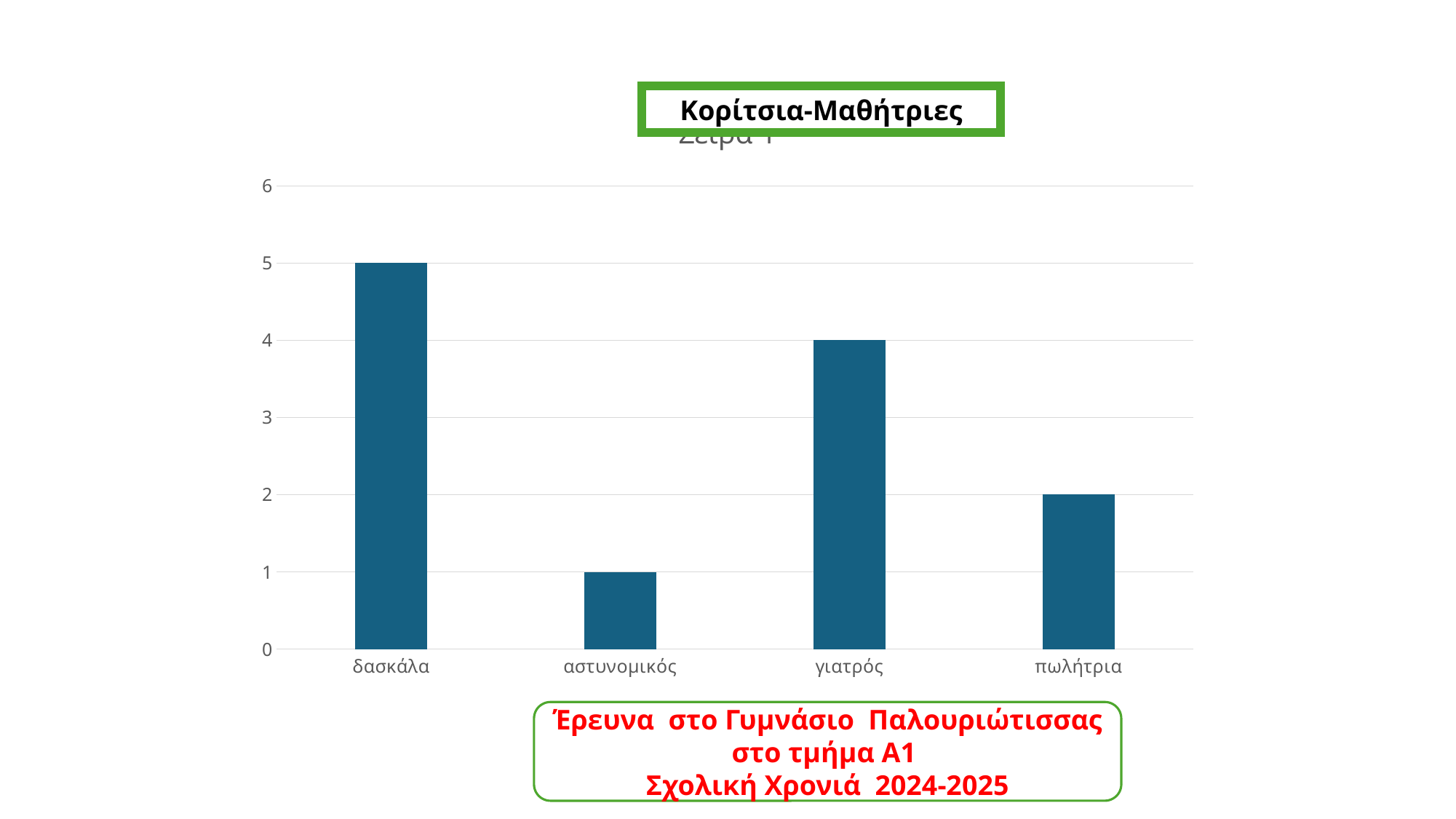
Which category has the lowest value? αστυνομικός Which category has the highest value? δασκάλα What is the value for αστυνομικός? 1 What kind of chart is shown on the slide? bar chart Which is larger, the value for γιατρός or the value for πωλήτρια? γιατρός What text is shown in the green-bordered box above the chart? Κορίτσια-Μαθήτριες How many categories are shown on the x axis of the chart? 4 What is the value for πωλήτρια? 2 What is the value for γιατρός? 4 What is the value for δασκάλα? 5 Is the value for πωλήτρια greater or less than 3? less What is the difference between the values for δασκάλα and γιατρός? 1